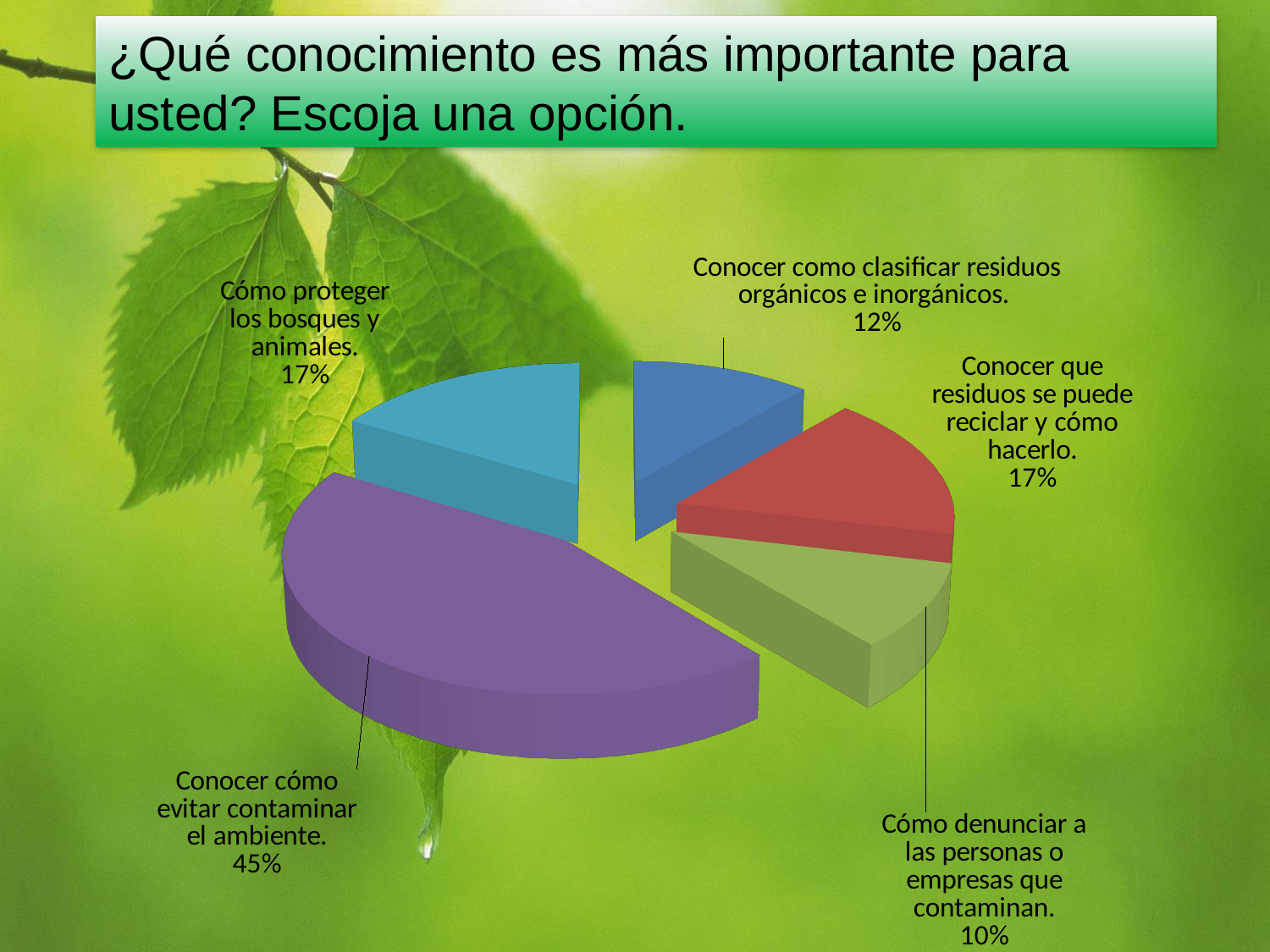
Which option has the smallest share of the pie? Cómo denunciar a las personas o empresas que contaminan What percentage is shown for "Cómo denunciar a las personas o empresas que contaminan"? 10% What colour is the slice for "Conocer cómo evitar contaminar el ambiente"? purple Which is larger: the share for "Conocer como clasificar residuos orgánicos e inorgánicos" or the share for "Cómo denunciar a las personas o empresas que contaminan"? Conocer como clasificar residuos orgánicos e inorgánicos What kind of chart is shown on the slide? pie chart What is the difference in percentage points between "Conocer cómo evitar contaminar el ambiente" and "Conocer que residuos se puede reciclar y cómo hacerlo"? 28 Which option has the largest share of the pie? Conocer cómo evitar contaminar el ambiente What percentage is shown for "Cómo proteger los bosques y animales"? 17% What is the title of the slide containing the pie chart? ¿Qué conocimiento es más importante para usted? Escoja una opción. How many slices does the pie chart have? 5 What percentage is shown for "Conocer cómo evitar contaminar el ambiente"? 45% What percentage is shown for "Conocer como clasificar residuos orgánicos e inorgánicos"? 12%